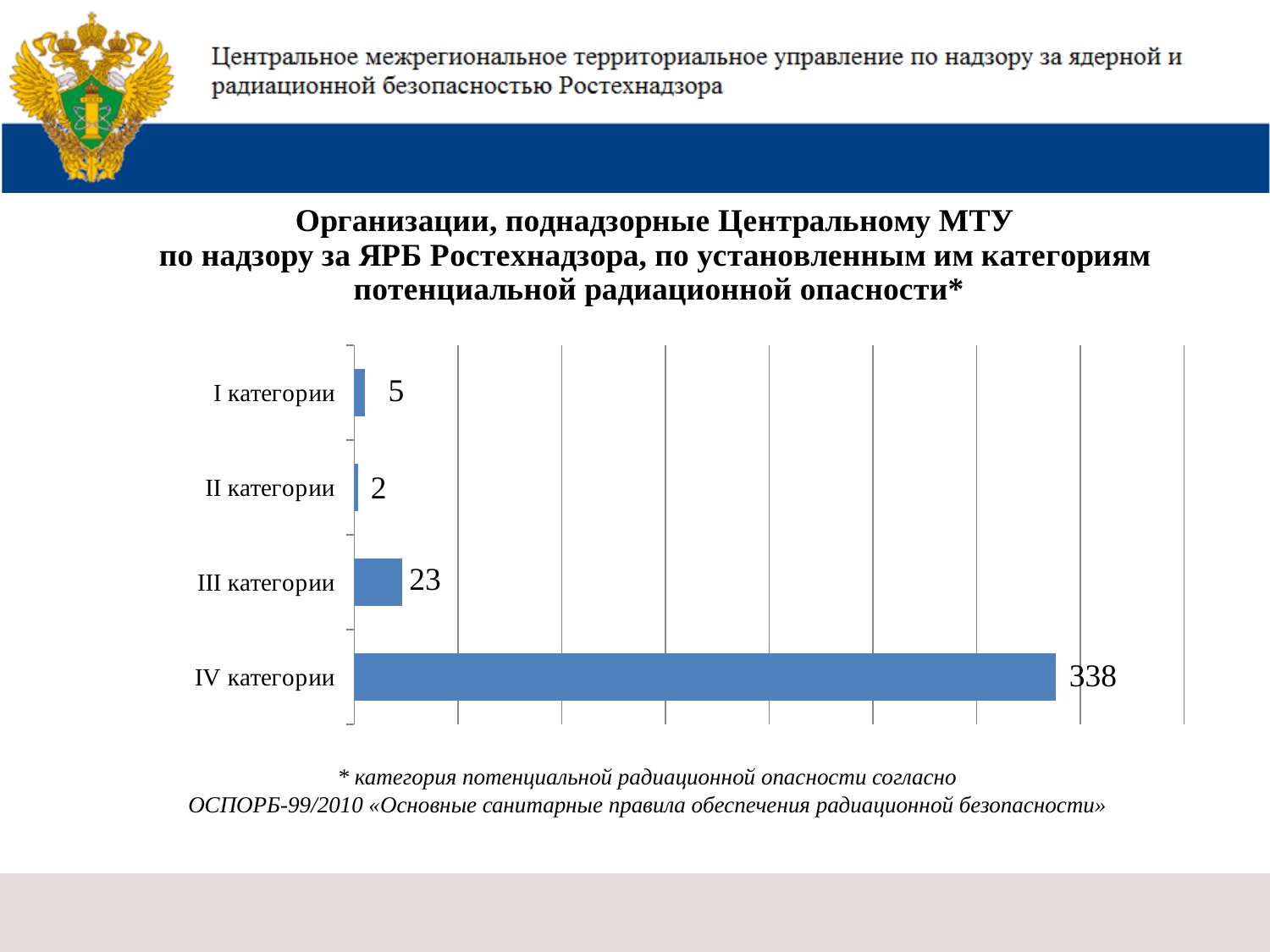
What kind of chart is shown on the slide? bar chart What is the difference between the values for IV категории and III категории? 315 What is the total of all four category values? 368 What is the value for III категории? 23 How many categories are shown in the chart? 4 What is the value for IV категории? 338 Which category has the highest value? IV категории Which category has the lowest value? II категории What is the value for I категории? 5 What is the value for II категории? 2 What is the difference between the values for III категории and I категории? 18 Which is larger, the value for I категории or the value for II категории? I категории